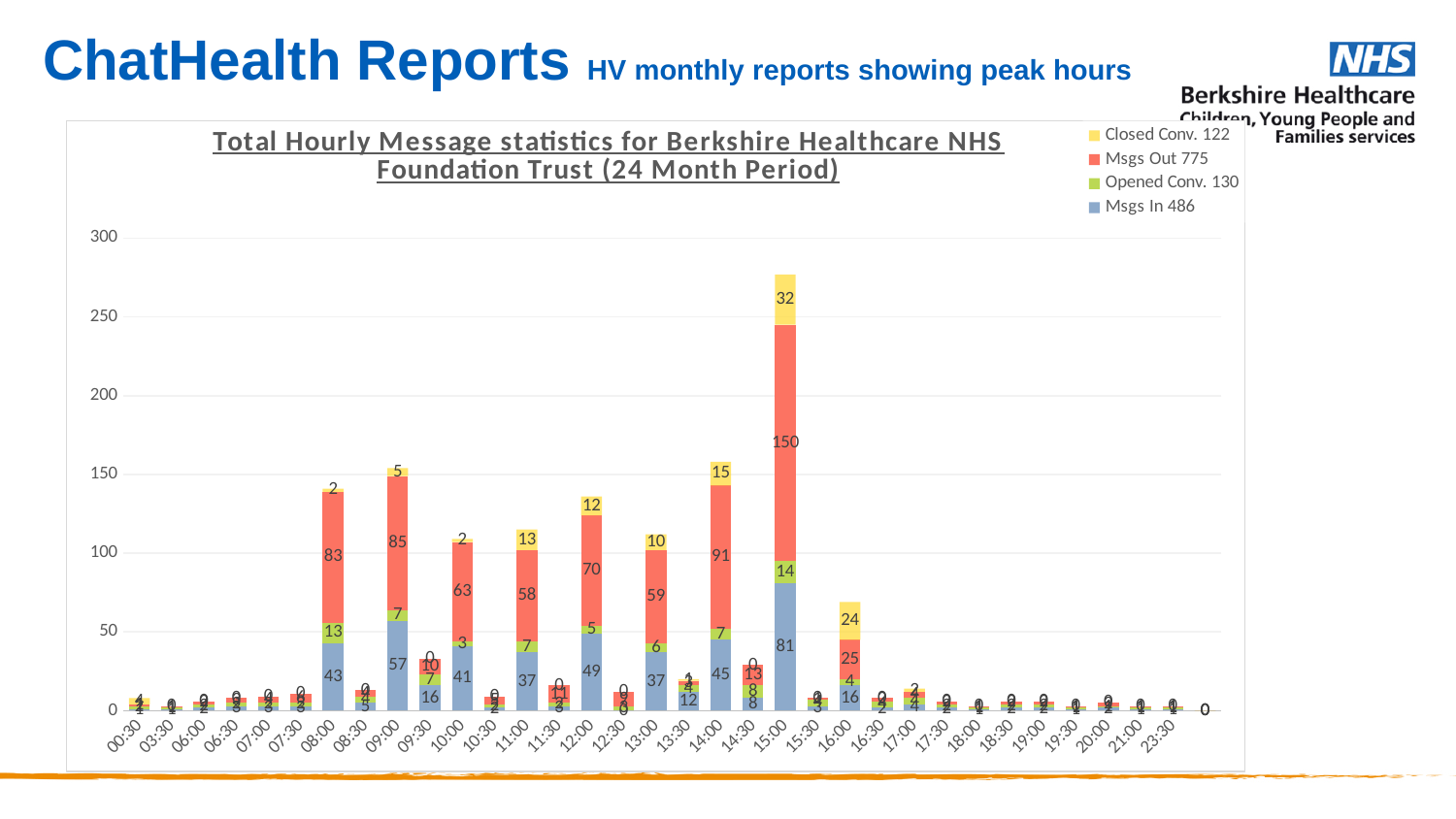
What is the total of the stacked bar at 08:00? 141 According to the legend, what is the overall total for Msgs Out? 775 What kind of chart is shown on the slide? Stacked bar chart How many series does the legend list? 4 Which time slot has the tallest stacked bar? 15:00 What is the Msgs Out value for the 15:00 bar? 150 What is the total of the stacked bar at 15:00? 277 What is the Msgs In value for the 09:00 bar? 57 Which has the larger Msgs In value, 12:00 or 10:00? 12:00 What is the Closed Conv. value for the 16:00 bar? 24 Is the total height of the 15:00 bar greater or less than 250? greater What is the difference between the Msgs Out values at 14:00 and 08:00? 8